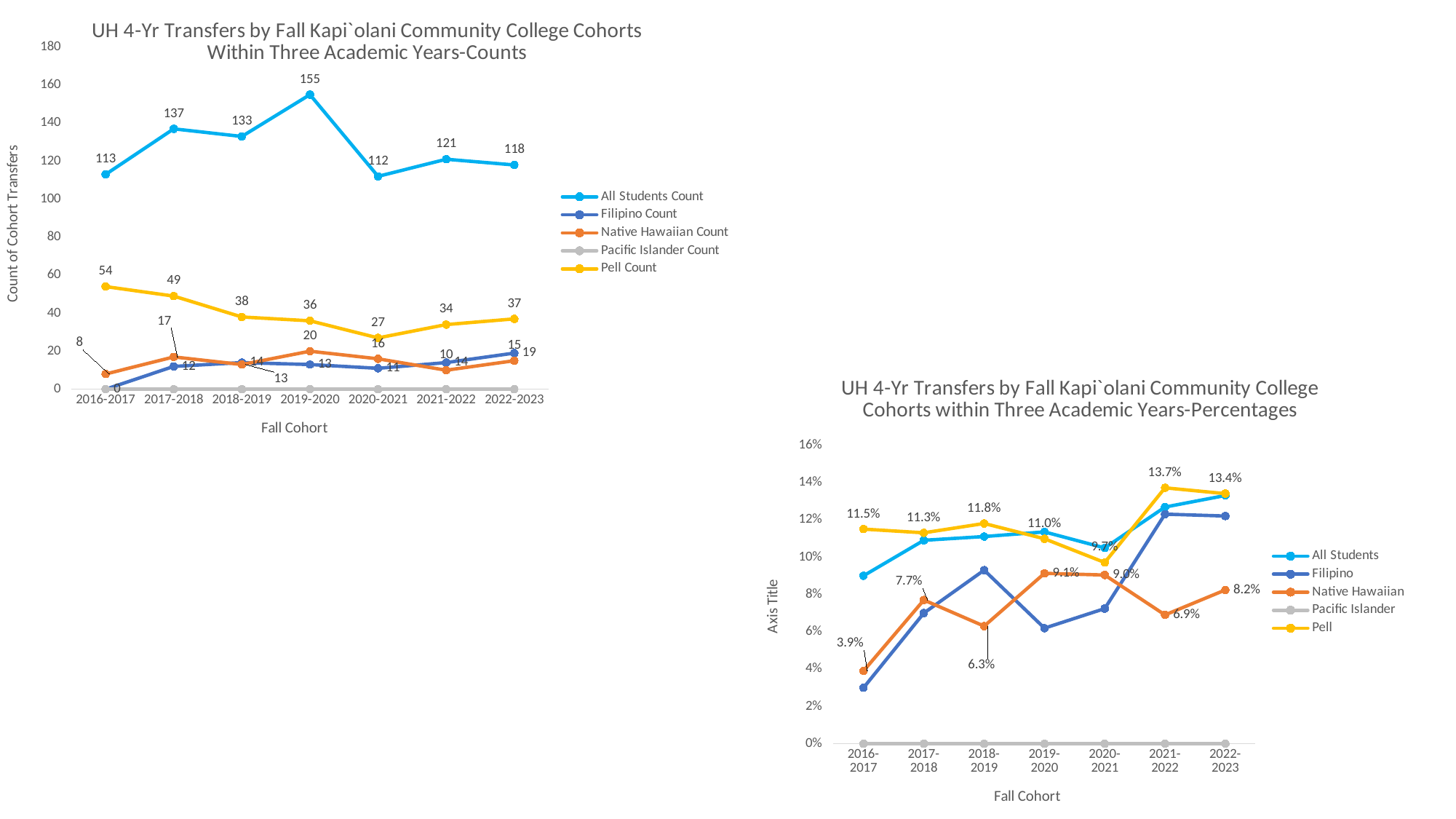
What kind of chart is the left chart, 'UH 4-Yr Transfers ... Within Three Academic Years-Counts'? Line chart How many fall cohorts are shown on the x axis of the Counts chart on the left? 7 In the Percentages chart on the right, which fall cohort has the highest Pell percentage? 2021-2022 In the Counts chart on the left, how much higher is the All Students Count for 2017-2018 than for 2016-2017? 24 In the Counts chart on the left, what is the All Students Count for the 2019-2020 cohort? 155 In the Percentages chart on the right, is the Native Hawaiian percentage higher for 2019-2020 or for 2021-2022? 2019-2020 In the Counts chart on the left, which fall cohort has the lowest Pell Count? 2020-2021 In the Counts chart on the left, what is the Pell Count for the 2016-2017 cohort? 54 In the Percentages chart on the right, what is the Native Hawaiian percentage for the 2016-2017 cohort? 3.9% In the Percentages chart on the right, is the All Students value for the 2016-2017 cohort greater or less than 10%? less How many series does the legend of the Counts chart on the left list? 5 In the Counts chart on the left, which fall cohort has the highest All Students Count? 2019-2020